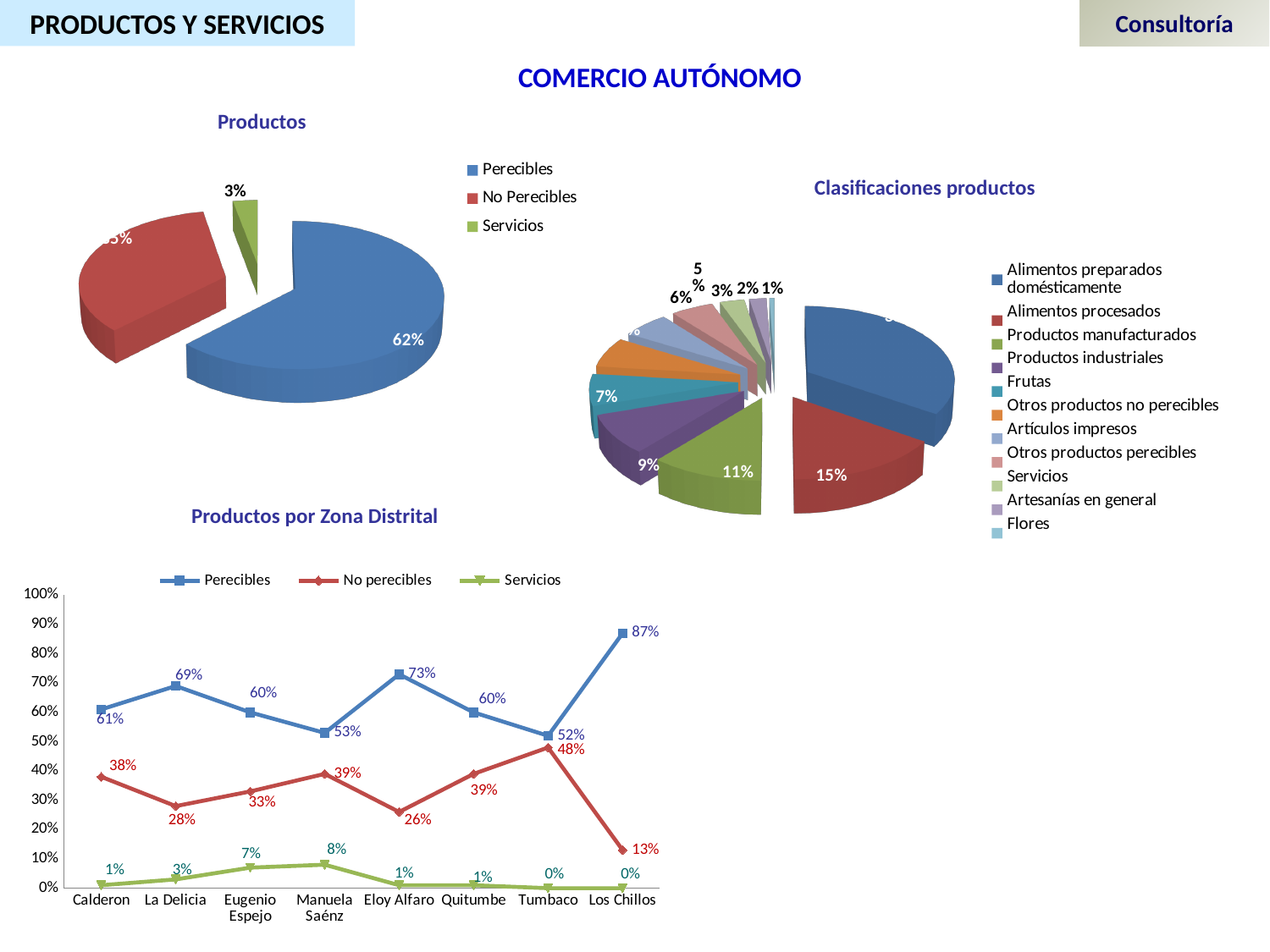
In the 'Productos' pie chart, which category has the largest slice? Perecibles In the 'Productos' pie chart, what percentage is shown for Servicios? 3% In the 'Productos' pie chart, what percentage is shown for Perecibles? 62% In the 'Productos por Zona Distrital' chart, which zone has the highest Servicios value? Manuela Saénz In the 'Productos por Zona Distrital' chart, what is the Perecibles value for Los Chillos? 87% In the 'Productos por Zona Distrital' chart, what is the No perecibles value for Tumbaco? 48% In the 'Clasificaciones productos' pie chart, what percentage is shown for Productos manufacturados? 11% What kind of chart is 'Productos por Zona Distrital'? Line chart In the 'Clasificaciones productos' pie chart, what percentage is shown for Alimentos procesados? 15% In the 'Productos por Zona Distrital' chart, how many zones are shown on the x axis? 8 In the 'Productos por Zona Distrital' chart, which zone has the lowest Perecibles value? Tumbaco How many entries does the legend of the 'Clasificaciones productos' chart list? 11